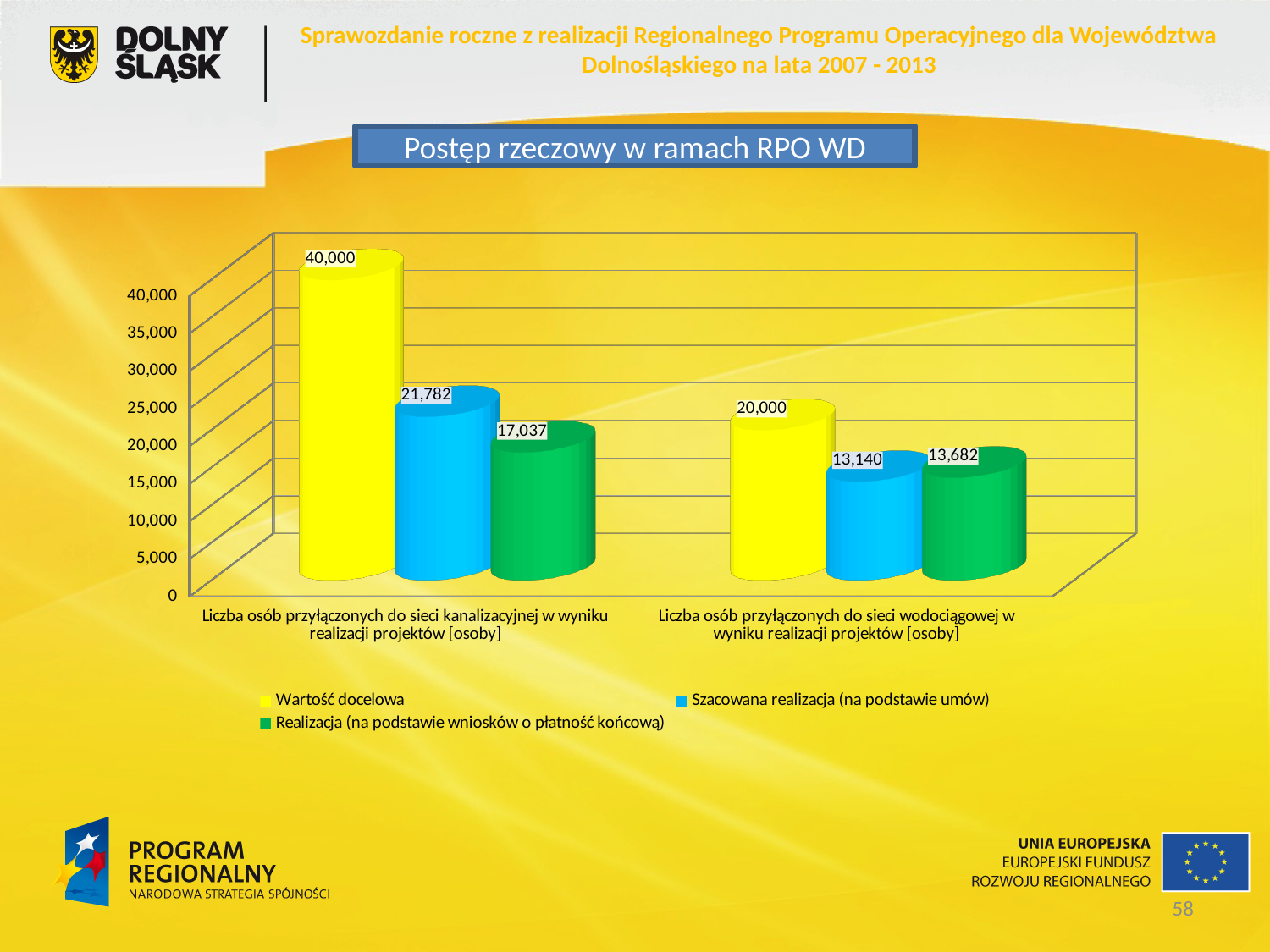
Which colour represents the 'Wartość docelowa' series in the chart? Yellow What kind of chart is shown on the slide? Bar chart How many series does the chart legend list? 3 What is the 'Szacowana realizacja (na podstawie umów)' value for 'Liczba osób przyłączonych do sieci wodociągowej w wyniku realizacji projektów [osoby]'? 13,140 What is the 'Wartość docelowa' value for 'Liczba osób przyłączonych do sieci wodociągowej w wyniku realizacji projektów [osoby]'? 20,000 For 'Liczba osób przyłączonych do sieci kanalizacyjnej w wyniku realizacji projektów [osoby]', which is larger: 'Szacowana realizacja (na podstawie umów)' or 'Realizacja (na podstawie wniosków o płatność końcową)'? Szacowana realizacja (na podstawie umów) How many categories are shown on the x axis of the chart? 2 Which category has the highest 'Wartość docelowa' value? Liczba osób przyłączonych do sieci kanalizacyjnej w wyniku realizacji projektów [osoby] What is the 'Wartość docelowa' value for 'Liczba osób przyłączonych do sieci kanalizacyjnej w wyniku realizacji projektów [osoby]'? 40,000 What is the difference between 'Wartość docelowa' and 'Szacowana realizacja (na podstawie umów)' for 'Liczba osób przyłączonych do sieci kanalizacyjnej w wyniku realizacji projektów [osoby]'? 18,218 What is the difference between 'Realizacja (na podstawie wniosków o płatność końcową)' and 'Szacowana realizacja (na podstawie umów)' for 'Liczba osób przyłączonych do sieci wodociągowej w wyniku realizacji projektów [osoby]'? 542 What is the 'Realizacja (na podstawie wniosków o płatność końcową)' value for 'Liczba osób przyłączonych do sieci kanalizacyjnej w wyniku realizacji projektów [osoby]'? 17,037